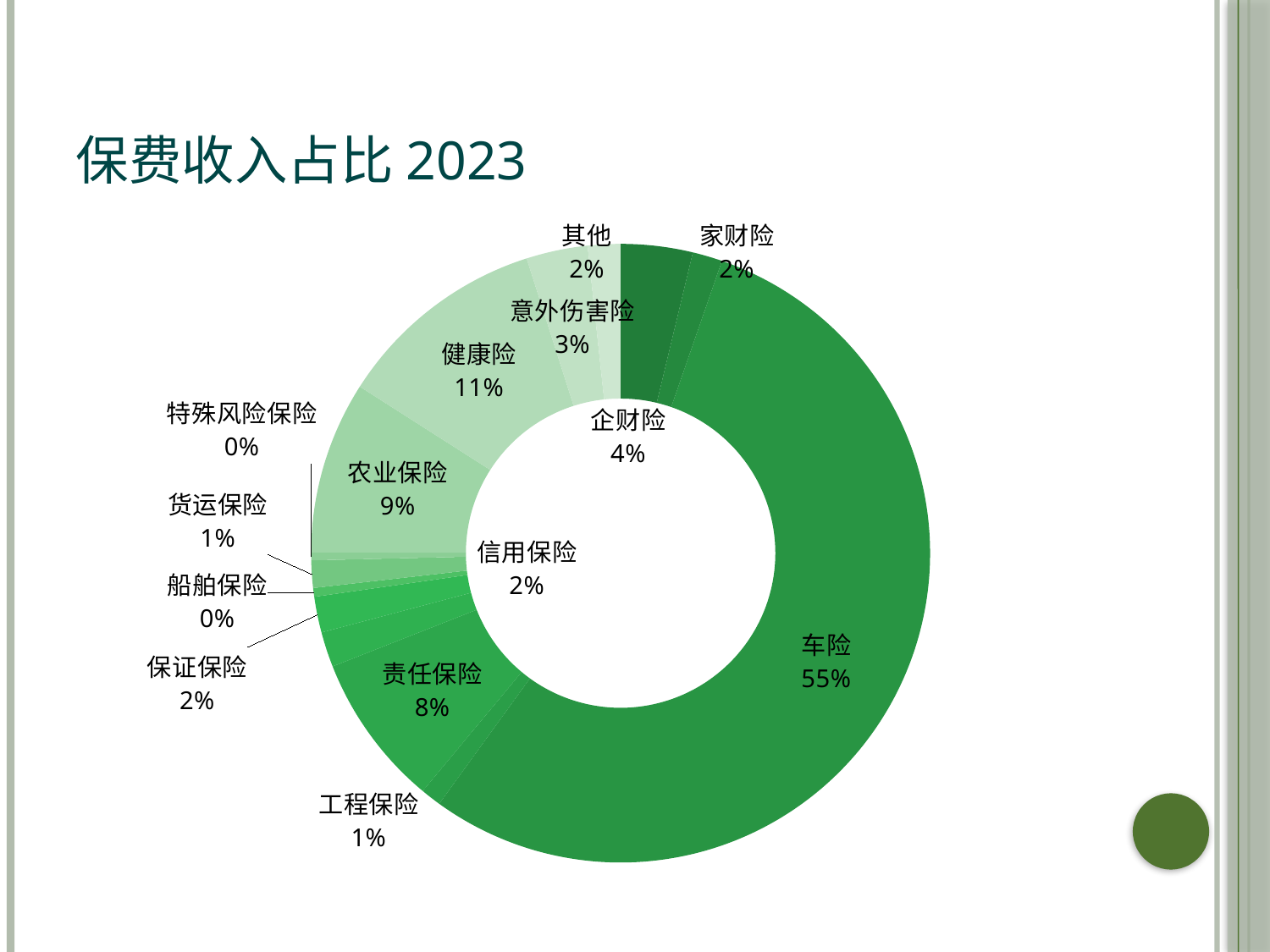
How many categories are shown in the chart? 14 Which category has the largest share of premium income? 车险 What is the value shown for 责任保险? 8% What percentage is shown for 企财险? 4% What percentage is shown for 农业保险? 9% What is the value shown for 健康险? 11% What share of premium income does 车险 account for? 55% Which has a larger share, 健康险 or 意外伤害险? 健康险 What kind of chart is shown on the slide? Doughnut chart Which has a larger share, 农业保险 or 责任保险? 农业保险 What is the title of the chart? 保费收入占比 2023 What is the difference between the shares of 车险 and 健康险? 44%